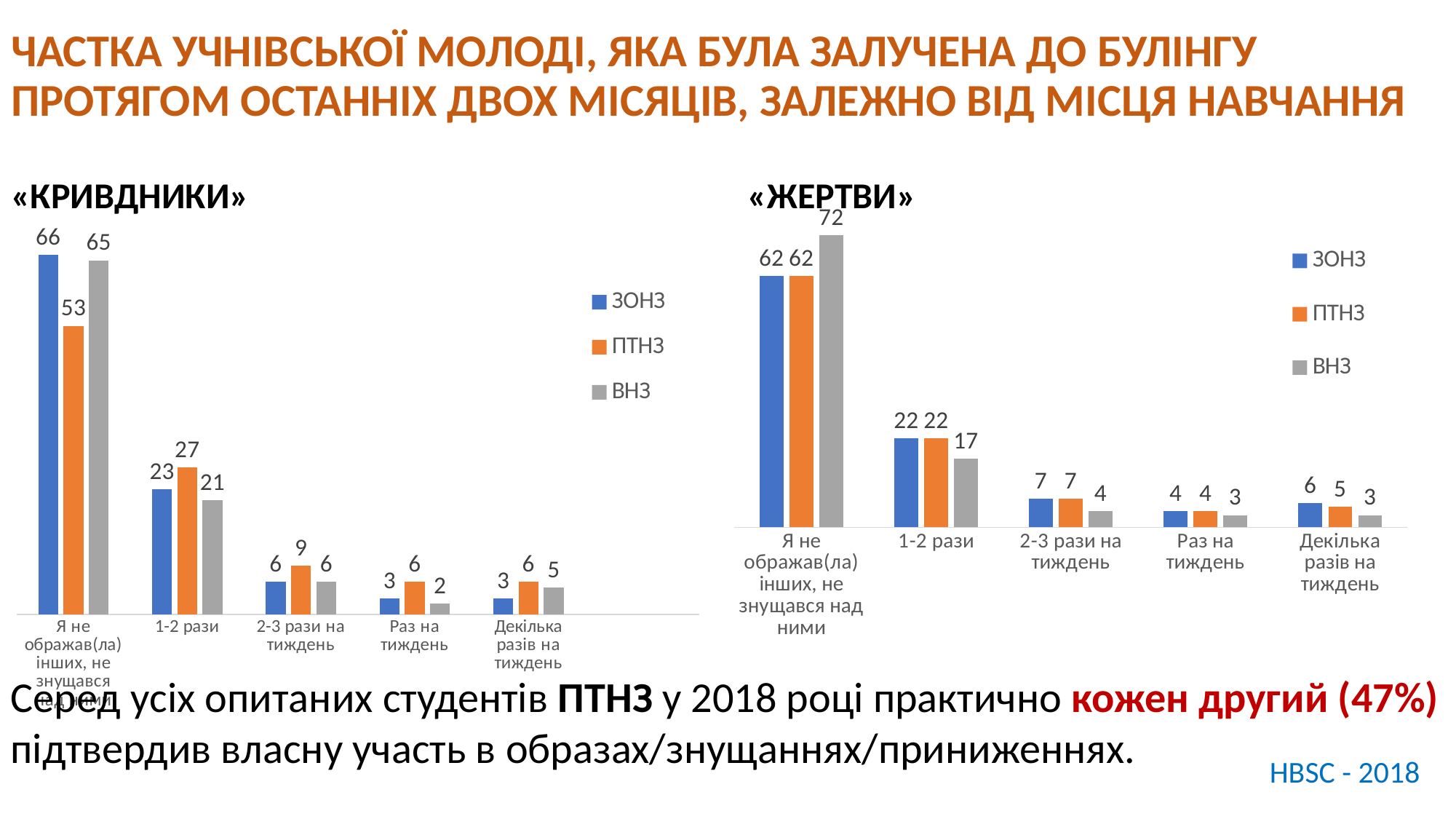
Which series is shown in orange in the «КРИВДНИКИ» chart? ПТНЗ In the «ЖЕРТВИ» chart, what is the value for ВНЗ in the «Я не ображав(ла) інших, не знущався над ними» category? 72 How many categories are shown on the x axis of the «ЖЕРТВИ» chart? 5 In the «ЖЕРТВИ» chart, do the ВНЗ values rise or fall from «Я не ображав(ла) інших, не знущався над ними» to «Декілька разів на тиждень»? Fall In the «ЖЕРТВИ» chart, which series has the lowest value in the «1-2 рази» category? ВНЗ In the «КРИВДНИКИ» chart, which series has the highest value in the «Я не ображав(ла) інших, не знущався над ними» category? ЗОНЗ In the «КРИВДНИКИ» chart, what is the value for ПТНЗ in the «1-2 рази» category? 27 In the «КРИВДНИКИ» chart, what is the difference between the ЗОНЗ and ПТНЗ values in the «Я не ображав(ла) інших, не знущався над ними» category? 13 What kind of chart is the «ЖЕРТВИ» chart? Bar chart In the «ЖЕРТВИ» chart, what is the difference between the ЗОНЗ and ВНЗ values in the «1-2 рази» category? 5 How many series does the legend of the «КРИВДНИКИ» chart list? 3 In the «КРИВДНИКИ» chart, which is larger in the «Раз на тиждень» category: ПТНЗ or ВНЗ? ПТНЗ